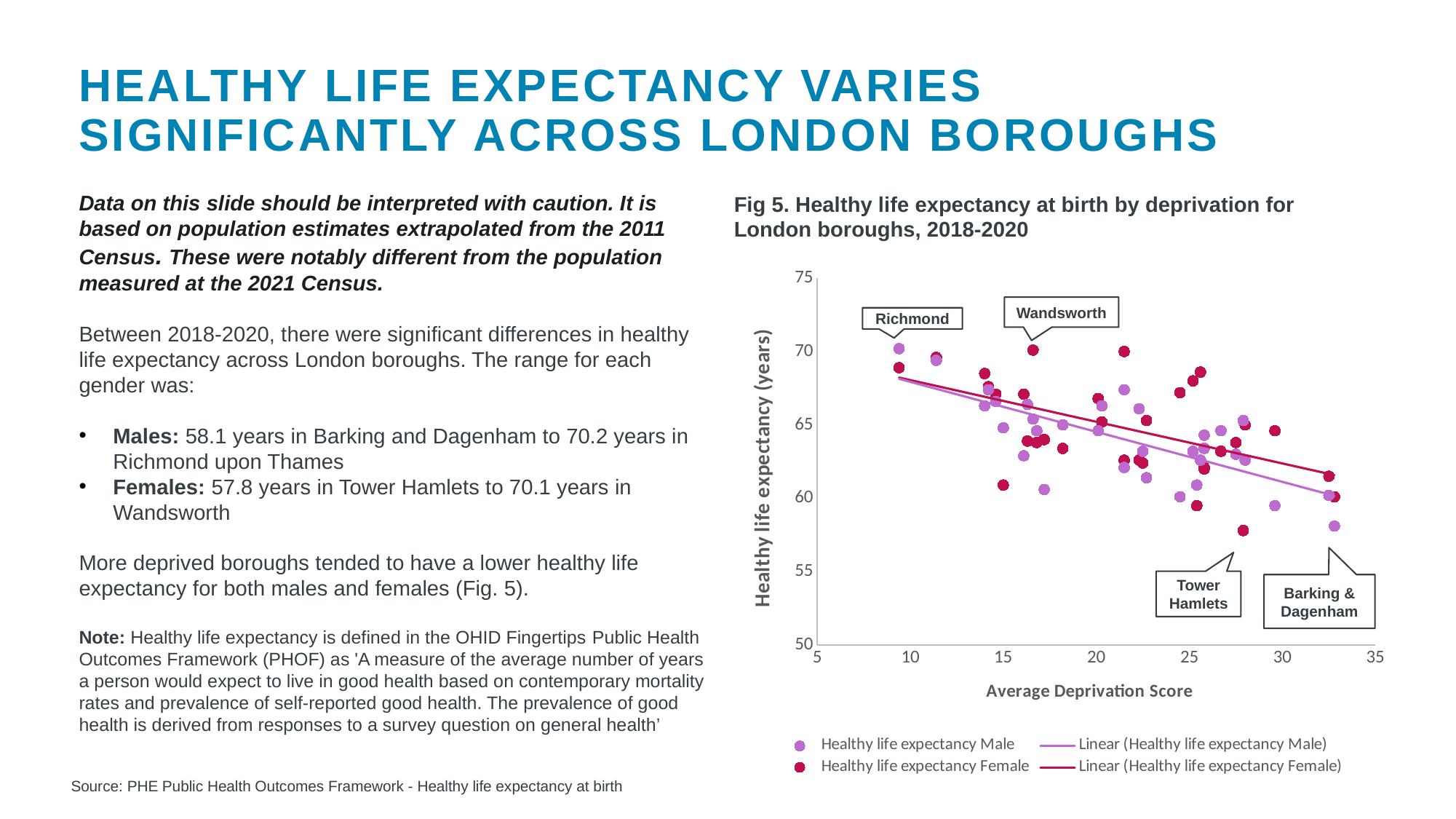
According to the slide, what is the male healthy life expectancy in Richmond upon Thames? 70.2 years In Fig 5, is the male healthy life expectancy value for Barking & Dagenham greater or less than 60? less How many entries does the legend of Fig 5 list? 4 In Fig 5, which has the higher male healthy life expectancy, Richmond or Barking & Dagenham? Richmond What is the title of the chart on the slide? Fig 5. Healthy life expectancy at birth by deprivation for London boroughs, 2018-2020 According to the slide, what is the female healthy life expectancy in Tower Hamlets? 57.8 years In Fig 5, is the healthy life expectancy value for the Richmond point greater or less than 65? greater What is the label of the x axis in Fig 5? Average Deprivation Score What kind of chart is Fig 5? Scatter chart In Fig 5, do healthy life expectancy values rise or fall as the average deprivation score increases? Fall In Fig 5, is the female healthy life expectancy value for Tower Hamlets greater or less than 60? less What is the difference between the male healthy life expectancy in Richmond upon Thames and in Barking and Dagenham, as stated on the slide? 12.1 years